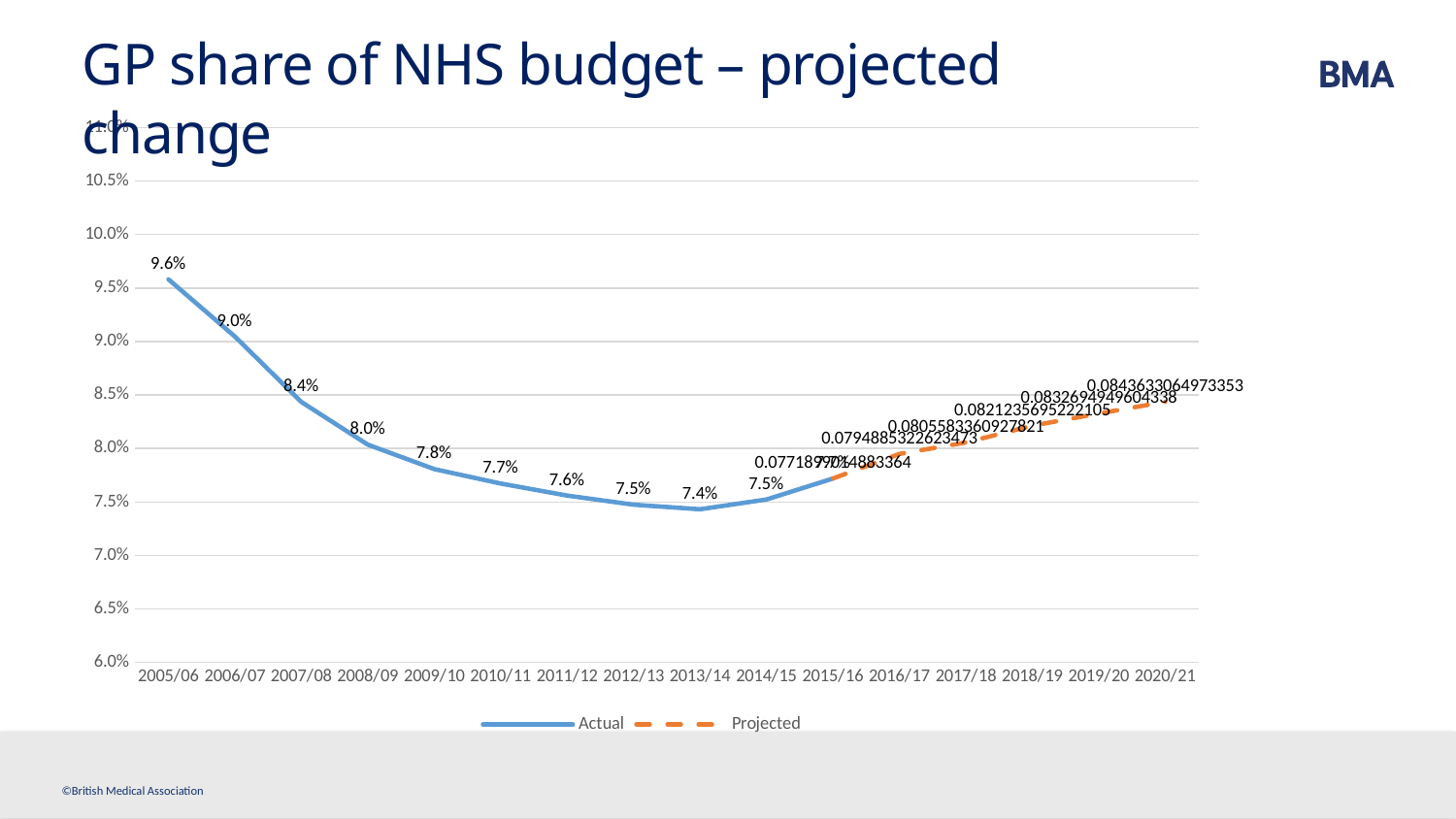
What is the GP share of NHS budget for 2013/14? 7.4% Which is larger, the value for 2009/10 or the value for 2011/12? 2009/10 What is the GP share of NHS budget for 2005/06? 9.6% What kind of chart is shown on the slide? Line chart What are the two series named in the legend? Actual and Projected Which year has the highest GP share of NHS budget? 2005/06 What is the difference between the values for 2005/06 and 2006/07? 0.6 percentage points How many series does the legend list? 2 Do the values rise or fall from 2005/06 to 2013/14? Fall What is the projected value labelled for 2020/21? 0.0843633064973353 How many years are shown on the x axis? 16 Which year has the lowest GP share of NHS budget? 2013/14